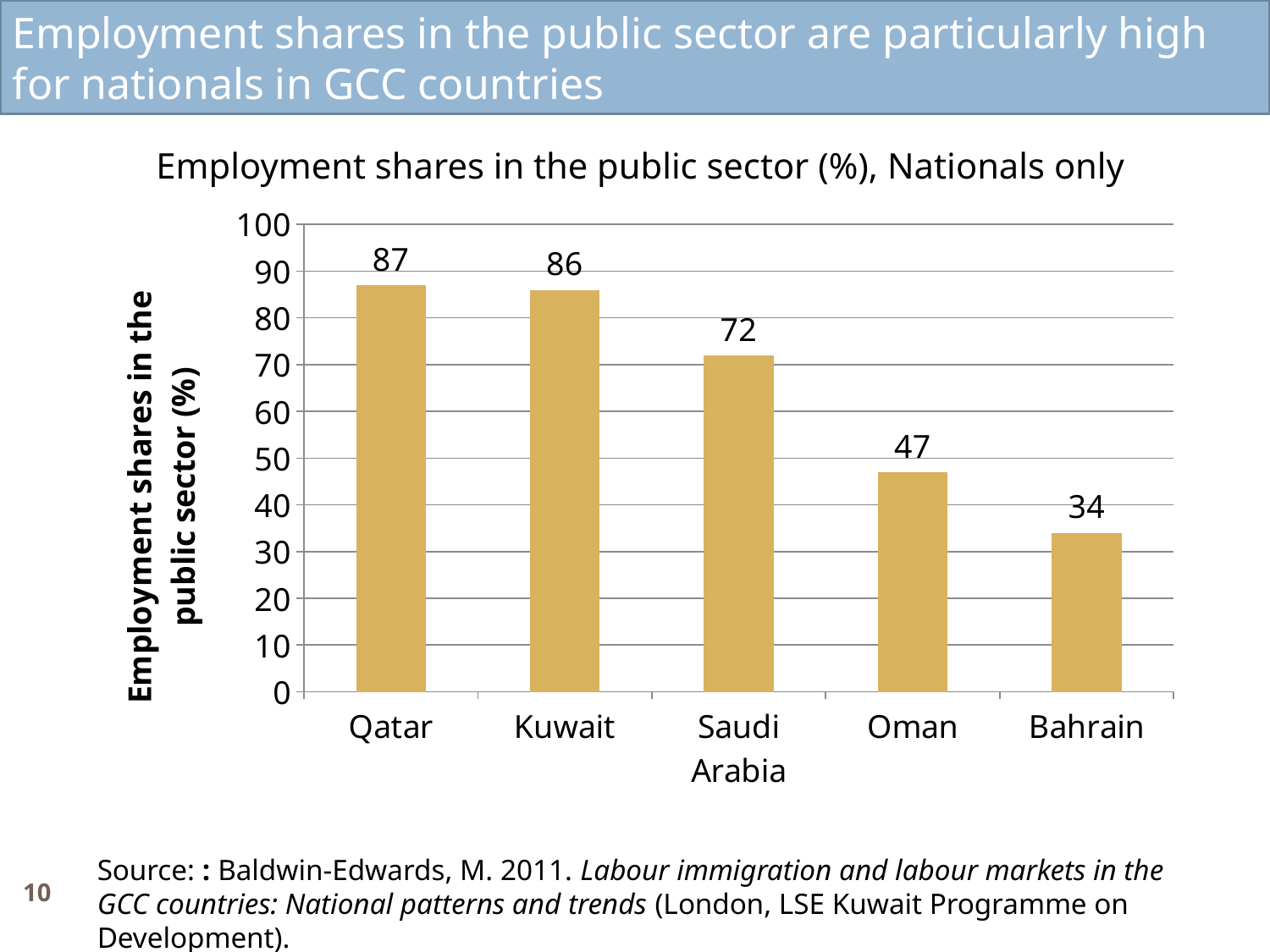
Is the value for Oman greater or less than 50? less Which country has the lowest employment share in the public sector? Bahrain Which country has the highest employment share in the public sector? Qatar How many countries are shown in the chart? 5 What is the employment share in the public sector for Saudi Arabia? 72 What is the difference between the employment shares for Qatar and Bahrain? 53 What kind of chart is shown on the slide? bar chart Which has a larger employment share in the public sector, Oman or Saudi Arabia? Saudi Arabia What is the title of the chart? Employment shares in the public sector (%), Nationals only What is the employment share in the public sector for Qatar? 87 What is the employment share in the public sector for Bahrain? 34 What is the difference between the employment shares for Saudi Arabia and Oman? 25